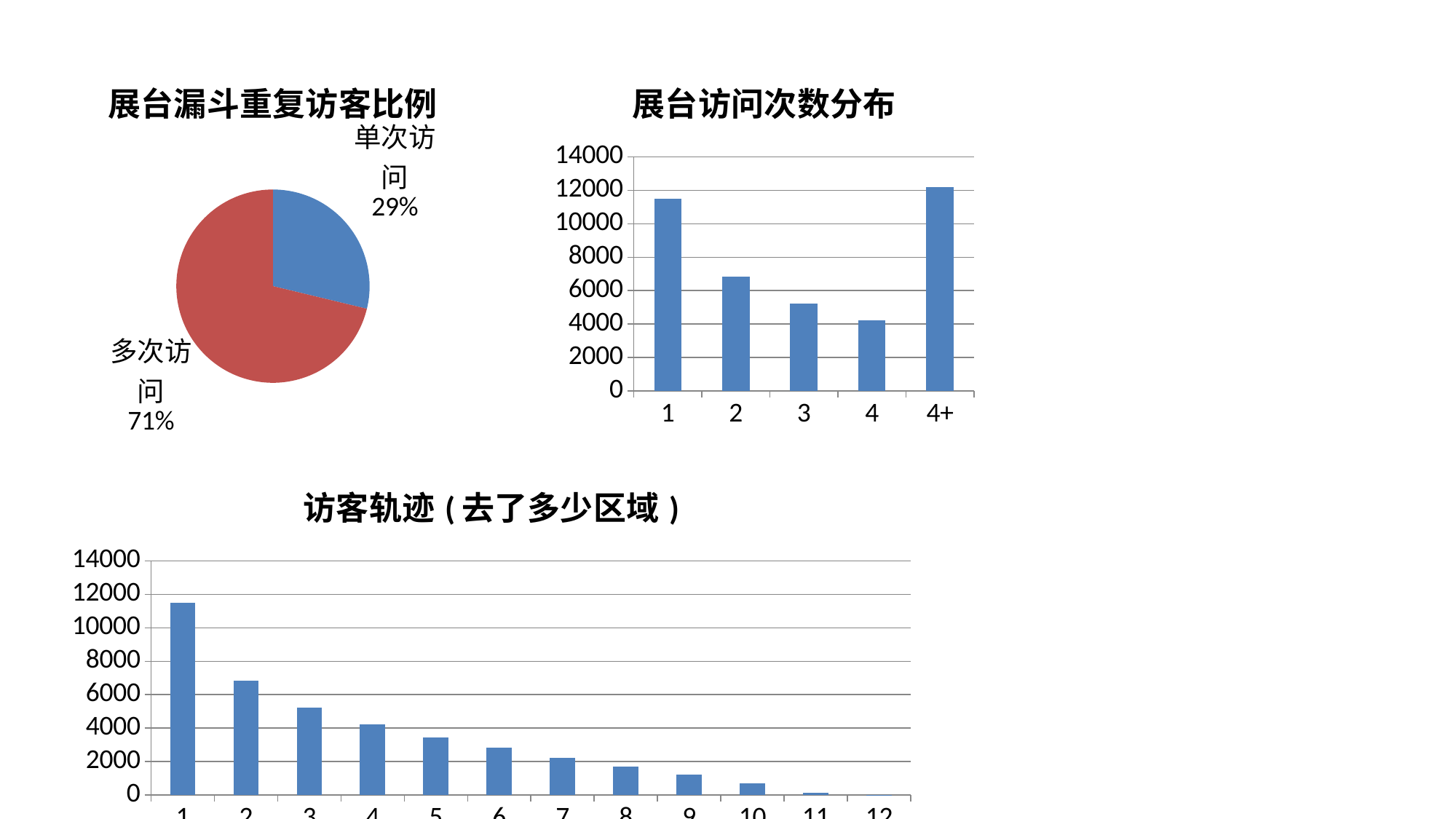
What kind of chart is the chart titled 展台访问次数分布? bar chart How many slices does the pie chart titled 展台漏斗重复访客比例 have? 2 In the pie chart titled 展台漏斗重复访客比例, which slice is larger, 单次访问 or 多次访问? 多次访问 In the pie chart titled 展台漏斗重复访客比例, what share is labelled for 单次访问? 29% In the chart titled 展台访问次数分布, is the value for category 2 greater or less than 6000? greater In the chart titled 访客轨迹（去了多少区域）, do the values rise or fall as you move from category 1 to category 12? fall In the chart titled 展台访问次数分布, which category has the highest value? 4+ In the chart titled 展台访问次数分布, which category has the lowest value? 4 In the chart titled 访客轨迹（去了多少区域）, is the value for category 1 greater or less than 10000? greater How many categories are shown on the x axis of the chart titled 访客轨迹（去了多少区域）? 12 How many categories are shown on the x axis of the chart titled 展台访问次数分布? 5 In the pie chart titled 展台漏斗重复访客比例, what share is labelled for 多次访问? 71%